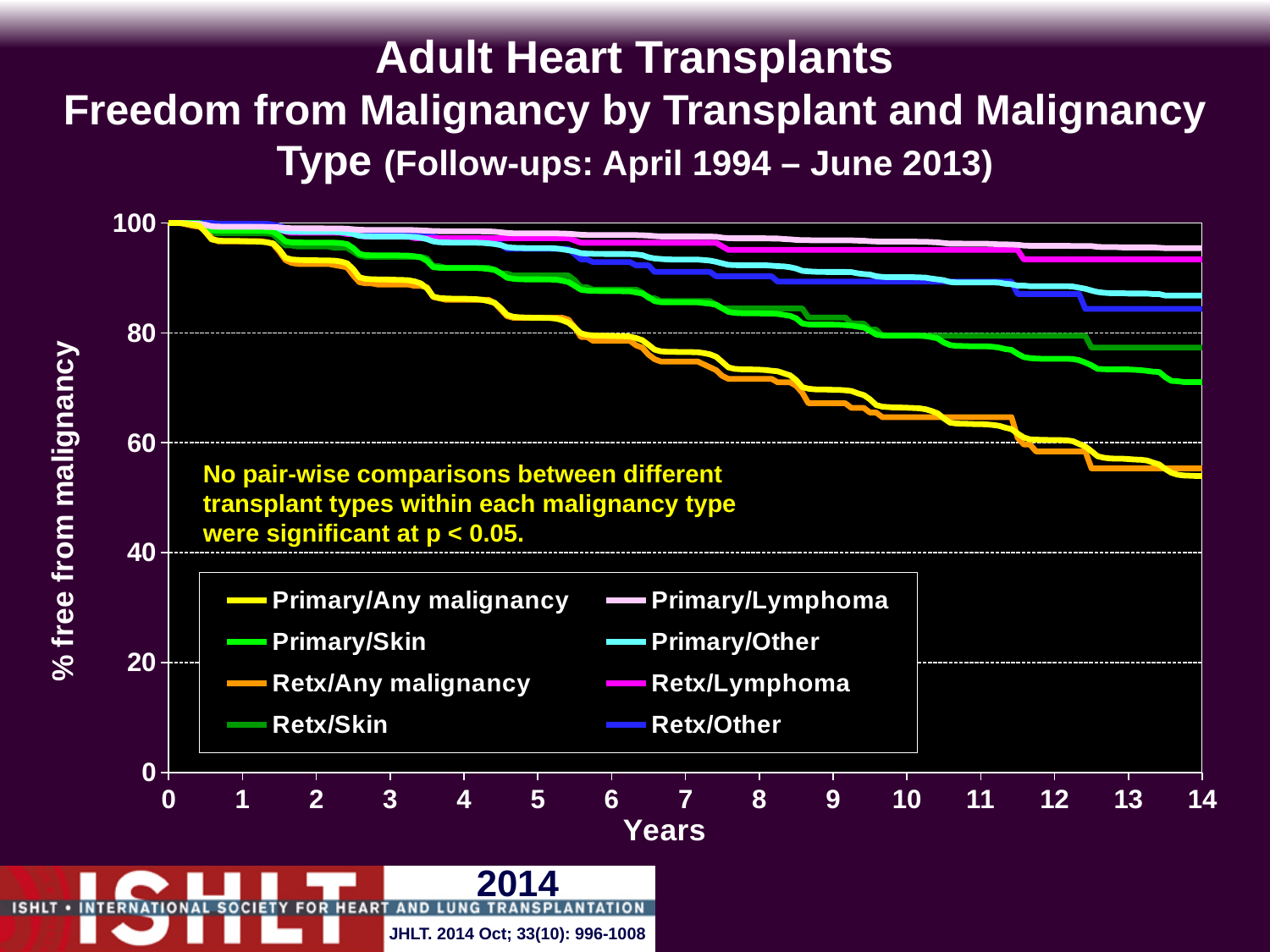
Is the value for Primary/Skin at 14 years greater or less than 60? greater At 14 years, which is higher: Primary/Lymphoma or Primary/Any malignancy? Primary/Lymphoma At 14 years, which is higher: Retx/Skin or Primary/Skin? Retx/Skin What is the label of the x axis? Years Is the value for Primary/Any malignancy at 14 years greater or less than 60? less How many series does the legend list? 8 Is the value for Primary/Lymphoma at 14 years greater or less than 80? greater What kind of chart is shown on the slide? Line chart Do the curves rise or fall as the number of years increases? Fall What is the label of the y axis? % free from malignancy